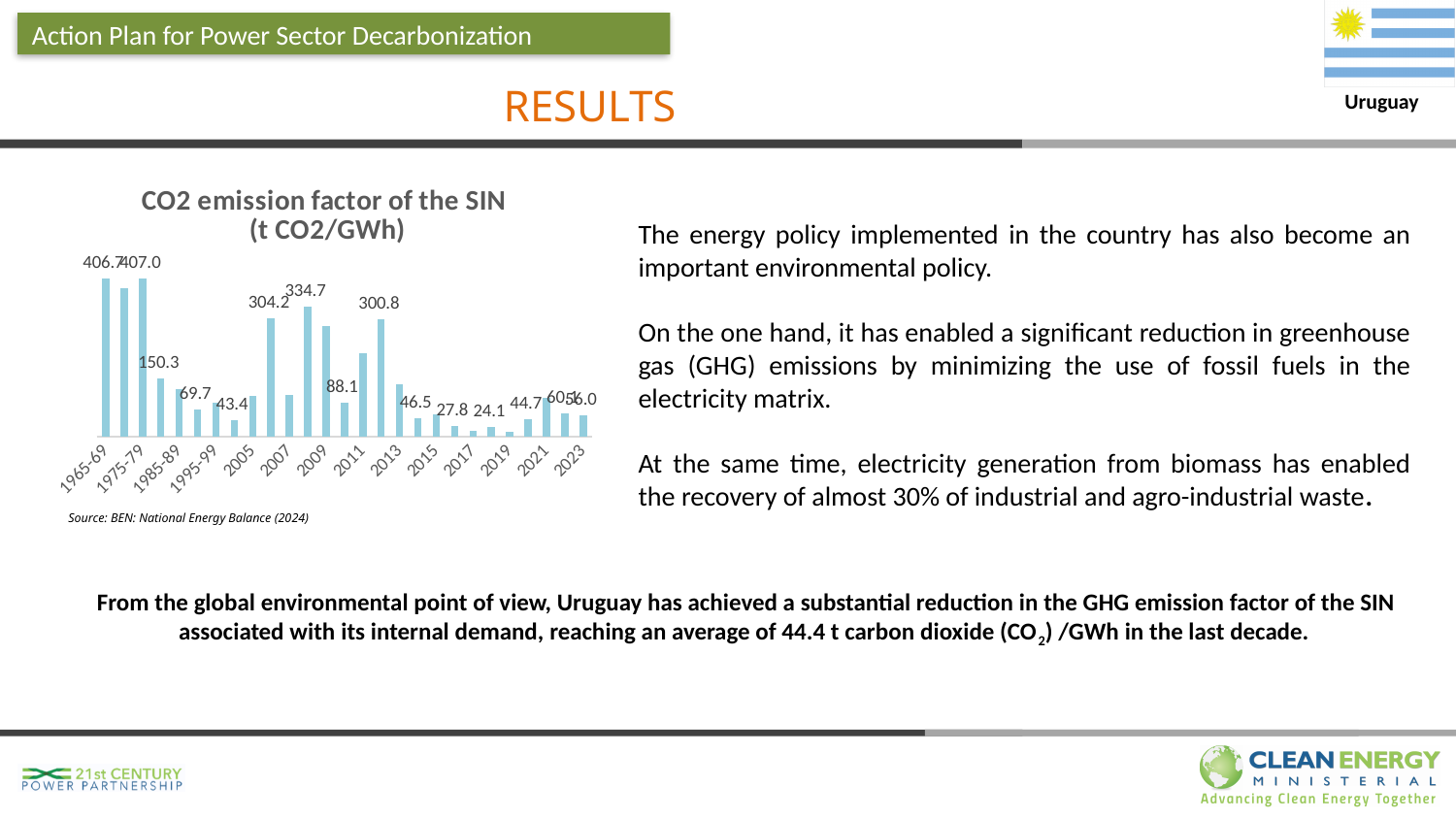
What is the CO2 emission factor for 1965-69? 406.7 What kind of chart is shown on the slide? bar chart Which is larger, the emission factor for 1965-69 or for 2023? 1965-69 What is the CO2 emission factor for 2023? 56.0 Overall, do the values rise or fall from 1965-69 to 2023? fall What is the highest value labelled on the chart? 407.0 What is the title of the chart? CO2 emission factor of the SIN (t CO2/GWh) What is the difference between the emission factor for 1965-69 and for 2023? 350.7 What source is cited below the chart? BEN: National Energy Balance (2024) What is the lowest value labelled on the chart? 24.1